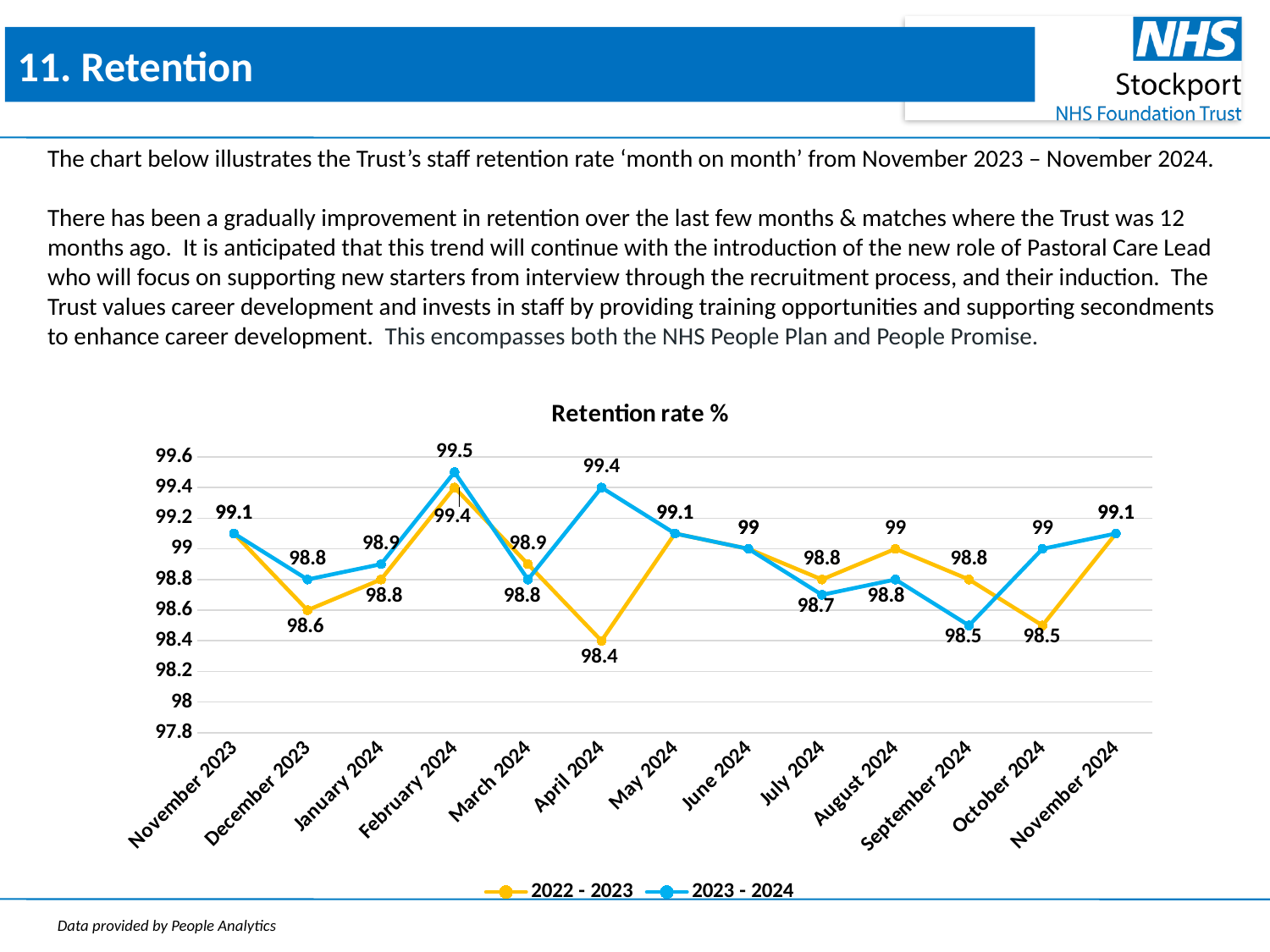
What is the 2022 - 2023 retention rate for September 2024? 98.8 What is the difference between the 2023 - 2024 and 2022 - 2023 values for April 2024? 1 In which month does the 2023 - 2024 series reach its highest value? February 2024 What is the 2023 - 2024 retention rate for April 2024? 99.4 What is the title of the chart? Retention rate % How many months are plotted along the x axis of the chart? 13 How many series does the chart legend list? 2 For October 2024, which series has the higher retention rate, 2022 - 2023 or 2023 - 2024? 2023 - 2024 In which month does the 2022 - 2023 series reach its lowest value? April 2024 What is the 2022 - 2023 retention rate for April 2024? 98.4 What is the 2023 - 2024 retention rate for February 2024? 99.5 What type of chart is shown on the slide? Line chart